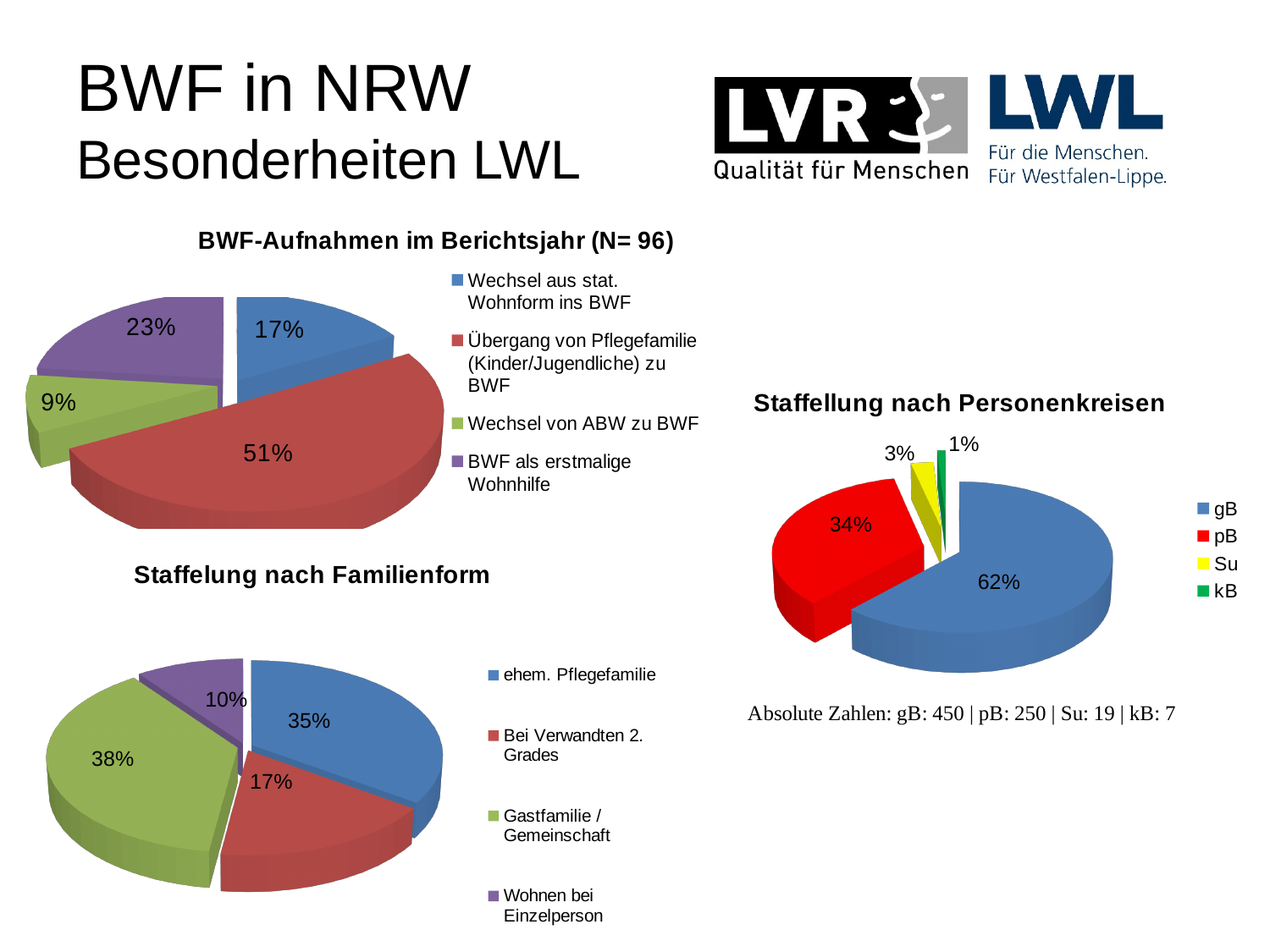
What kind of chart is 'Staffelung nach Familienform'? Pie chart How many categories does the chart 'BWF-Aufnahmen im Berichtsjahr (N= 96)' show? 4 How many entries does the legend of the chart 'Staffellung nach Personenkreisen' list? 4 In the chart 'BWF-Aufnahmen im Berichtsjahr (N= 96)', what share does 'Übergang von Pflegefamilie (Kinder/Jugendliche) zu BWF' have? 51% In the chart 'BWF-Aufnahmen im Berichtsjahr (N= 96)', what is the value for 'Wechsel von ABW zu BWF'? 9% In the chart 'Staffelung nach Familienform', which is larger: 'ehem. Pflegefamilie' or 'Bei Verwandten 2. Grades'? ehem. Pflegefamilie In the chart 'Staffellung nach Personenkreisen', what is the value for pB? 34% In the chart 'BWF-Aufnahmen im Berichtsjahr (N= 96)', what is the difference between 'BWF als erstmalige Wohnhilfe' and 'Wechsel aus stat. Wohnform ins BWF'? 6% In the chart 'Staffellung nach Personenkreisen', which category has the smallest share? kB In the chart 'Staffelung nach Familienform', what is the value for 'Gastfamilie / Gemeinschaft'? 38% In the chart 'Staffelung nach Familienform', which category has the largest share? Gastfamilie / Gemeinschaft In the chart 'BWF-Aufnahmen im Berichtsjahr (N= 96)', which category has the smallest share? Wechsel von ABW zu BWF